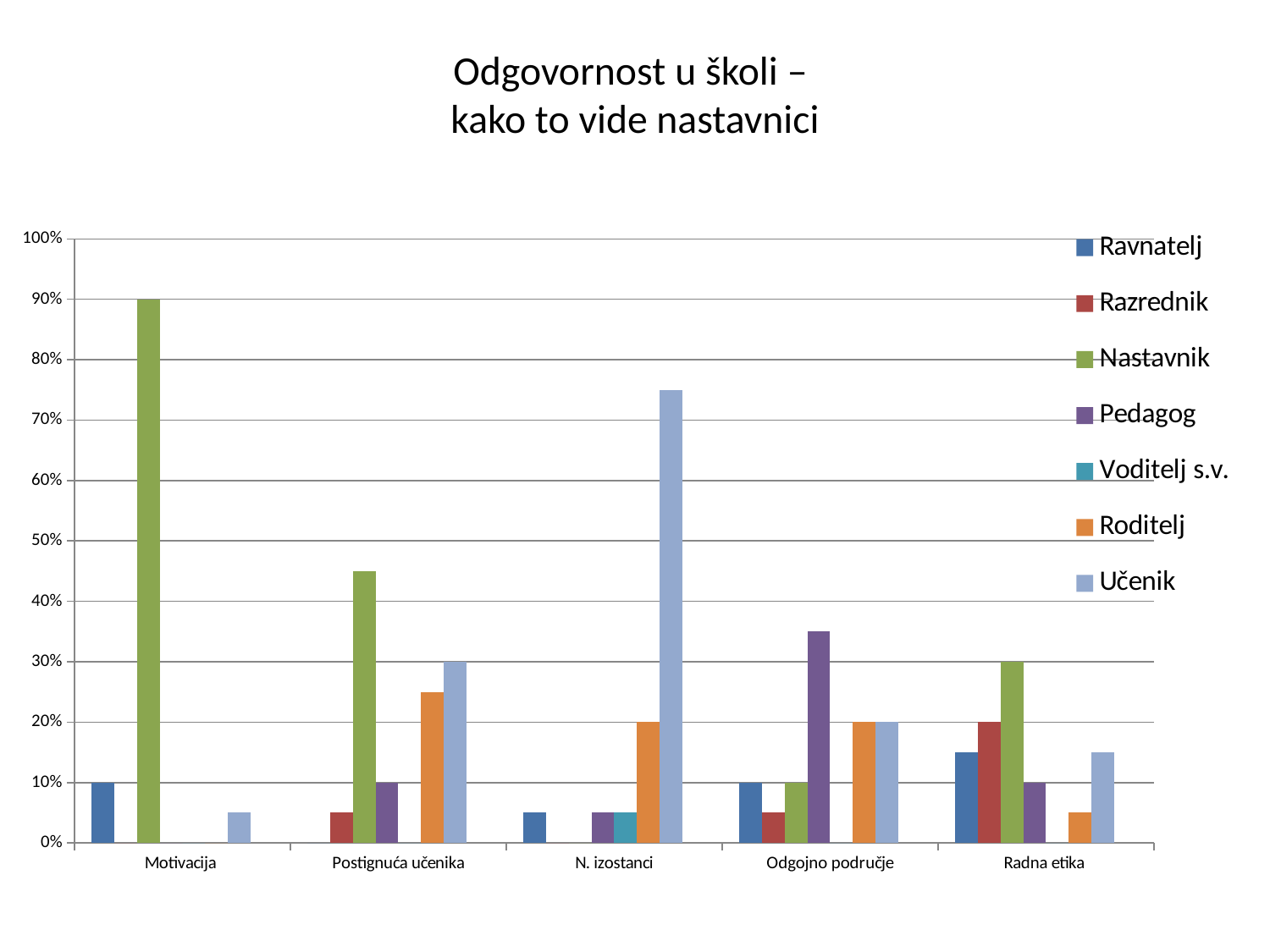
Is the value for Nastavnik in the Postignuća učenika category greater or less than 40%? greater What kind of chart is shown on the slide? bar chart What is the title of the chart? Odgovornost u školi – kako to vide nastavnici Is the value for Učenik in the N. izostanci category greater or less than 70%? greater What is the difference between the Nastavnik and Ravnatelj values in the Motivacija category? 80% What is the value for Roditelj in the N. izostanci category? 20% How many series does the legend list? 7 What is the value for Nastavnik in the Motivacija category? 90% In the Odgojno područje category, which is larger: Pedagog or Nastavnik? Pedagog How many categories are shown on the x axis? 5 Which series has the highest value in the Motivacija category? Nastavnik What is the value for Učenik in the Postignuća učenika category? 30%